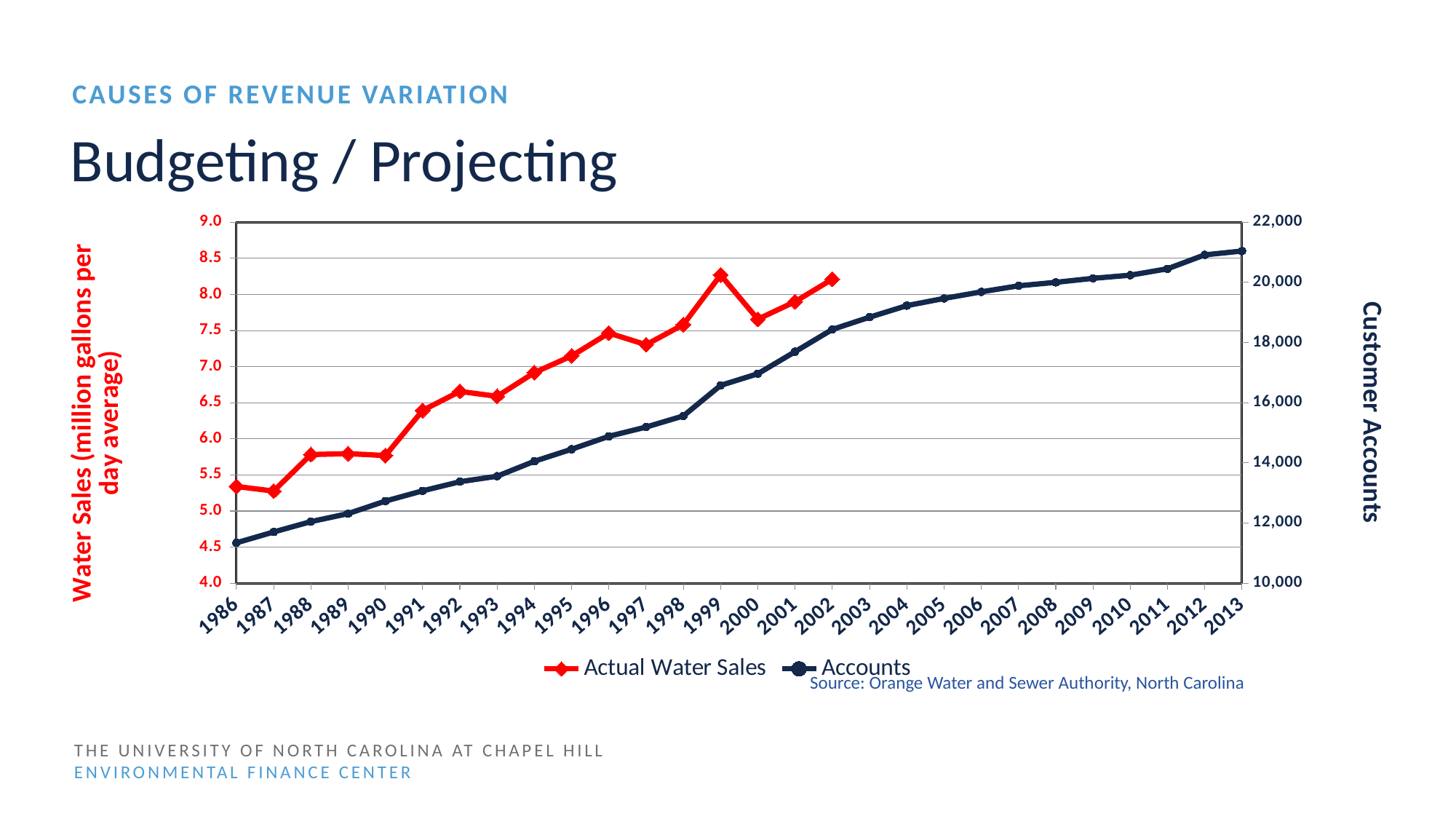
How many series does the legend list? 2 Is the Actual Water Sales value for 1986 greater or less than 5.5? less What are the two series named in the legend? Actual Water Sales and Accounts Which year has the larger Actual Water Sales value, 1999 or 2000? 1999 In which year does the Actual Water Sales series reach its highest value? 1999 What is the title of the right-hand vertical axis? Customer Accounts Does the Accounts series rise or fall from 1986 to 2013? Rises How many years are shown on the x axis? 28 In which year is the Accounts series lowest? 1986 What kind of chart is shown on the slide? Line chart Is the Actual Water Sales value for 1999 greater or less than 8.0? greater Is the Accounts value for 2013 greater or less than 20,000? greater